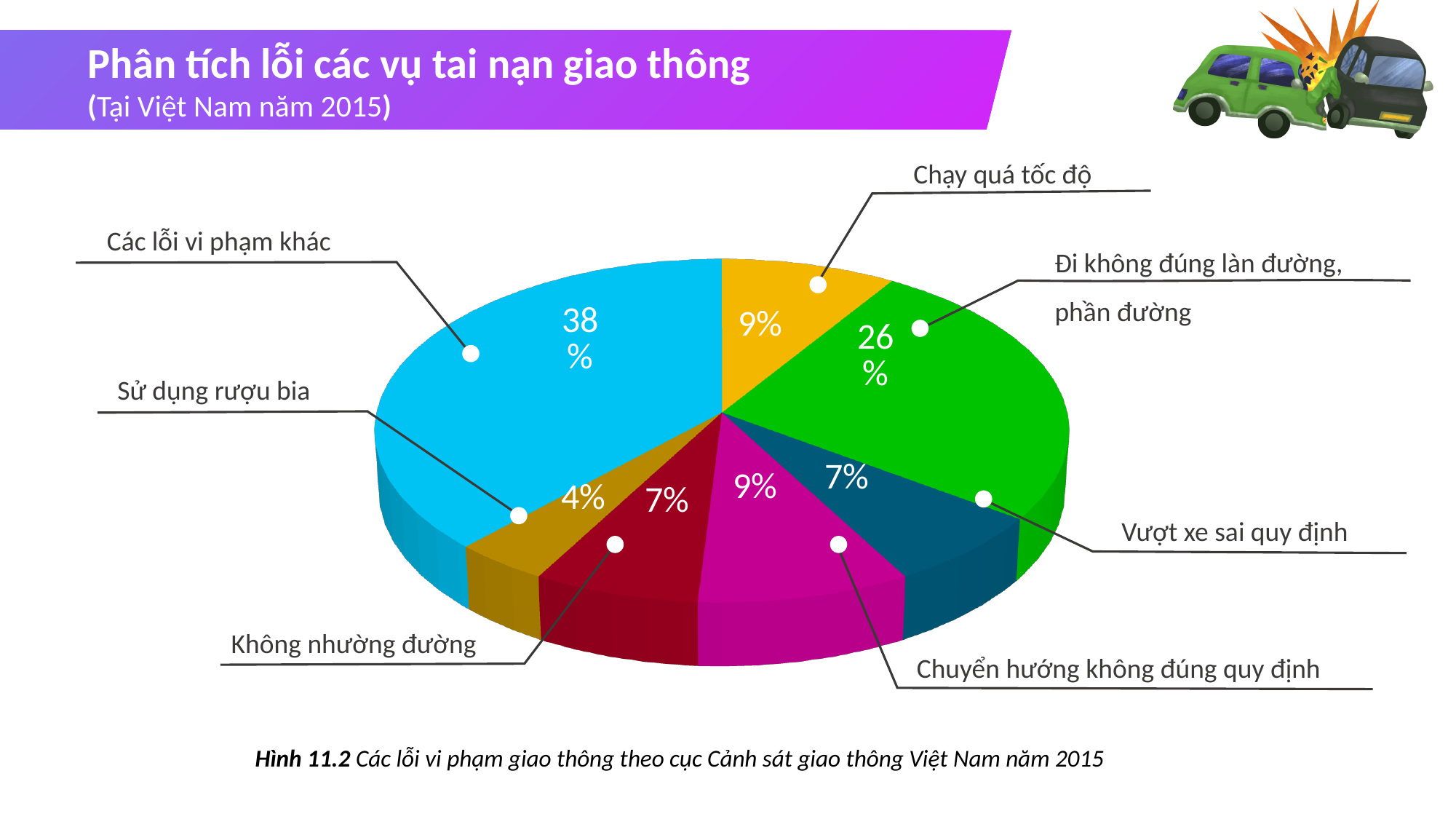
Which category has the largest slice of the pie? Các lỗi vi phạm khác What kind of chart is shown on the slide? Pie chart What is the value for "Đi không đúng làn đường, phần đường"? 26% Which category has the smallest slice of the pie? Sử dụng rượu bia What is the value for "Chạy quá tốc độ"? 9% Which is larger: "Chuyển hướng không đúng quy định" or "Không nhường đường"? Chuyển hướng không đúng quy định What percentage of traffic accidents is attributed to "Các lỗi vi phạm khác"? 38% How many categories are shown in the pie chart? 7 What share does "Sử dụng rượu bia" have in the pie chart? 4% What is the difference in percentage points between "Các lỗi vi phạm khác" and "Đi không đúng làn đường, phần đường"? 12 What year does the chart's data refer to, according to the title? 2015 What percentage is shown for "Vượt xe sai quy định"? 7%